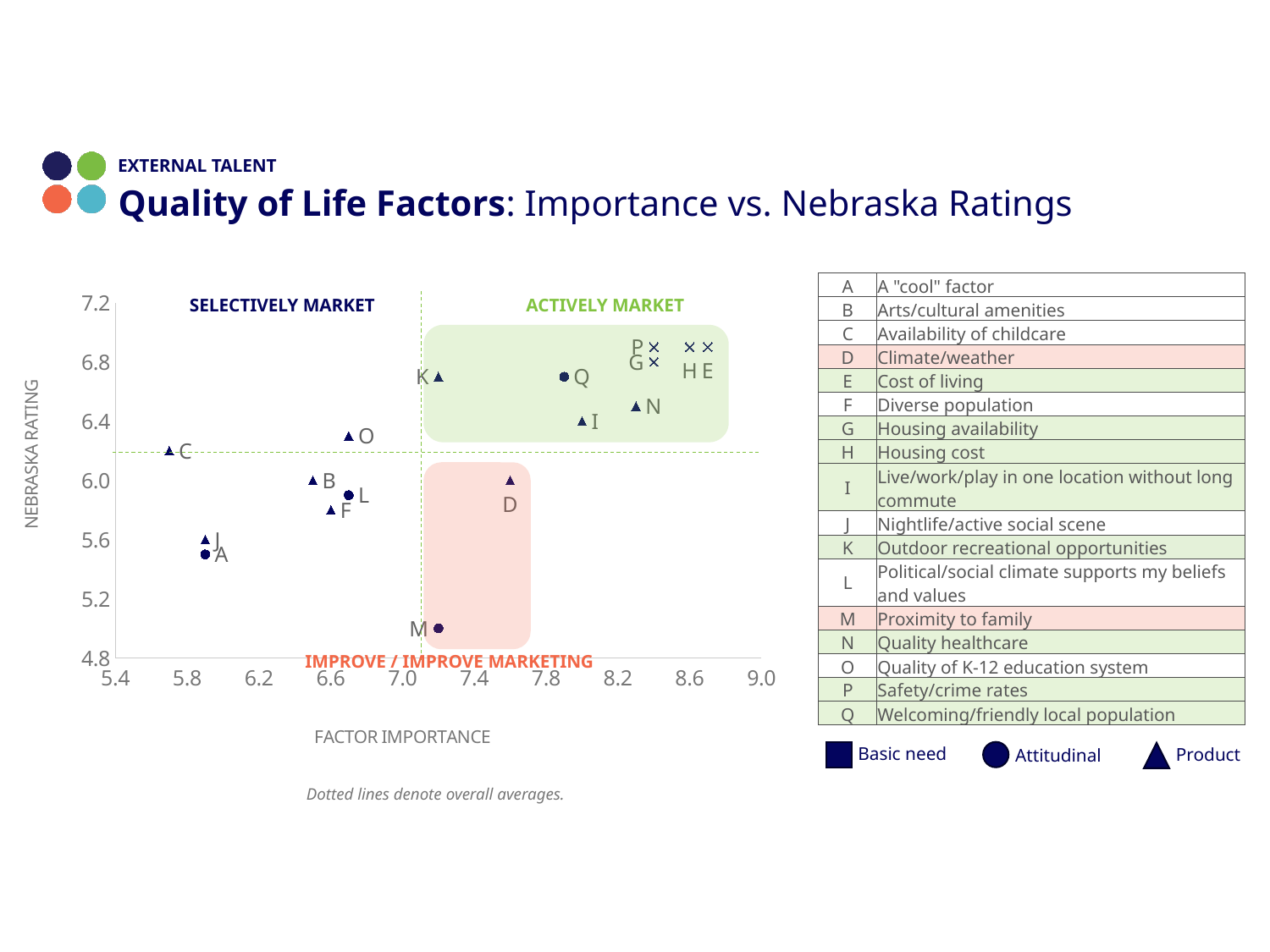
What kind of chart is shown on the slide? scatter chart Is the factor importance for N greater or less than 7.8? greater Is the Nebraska rating for D greater or less than 6.4? less What is the title of the horizontal axis? FACTOR IMPORTANCE Is the Nebraska rating for K greater or less than 6.4? greater Which factor has the lowest factor importance on the chart? C (Availability of childcare) Which has the higher Nebraska rating, Q or M? Q Which factor has the lowest Nebraska rating on the chart? M (Proximity to family) Which has the higher factor importance, K or C? K How many categories does the legend below the table list? 3 How many labeled factors (points) are plotted on the chart? 17